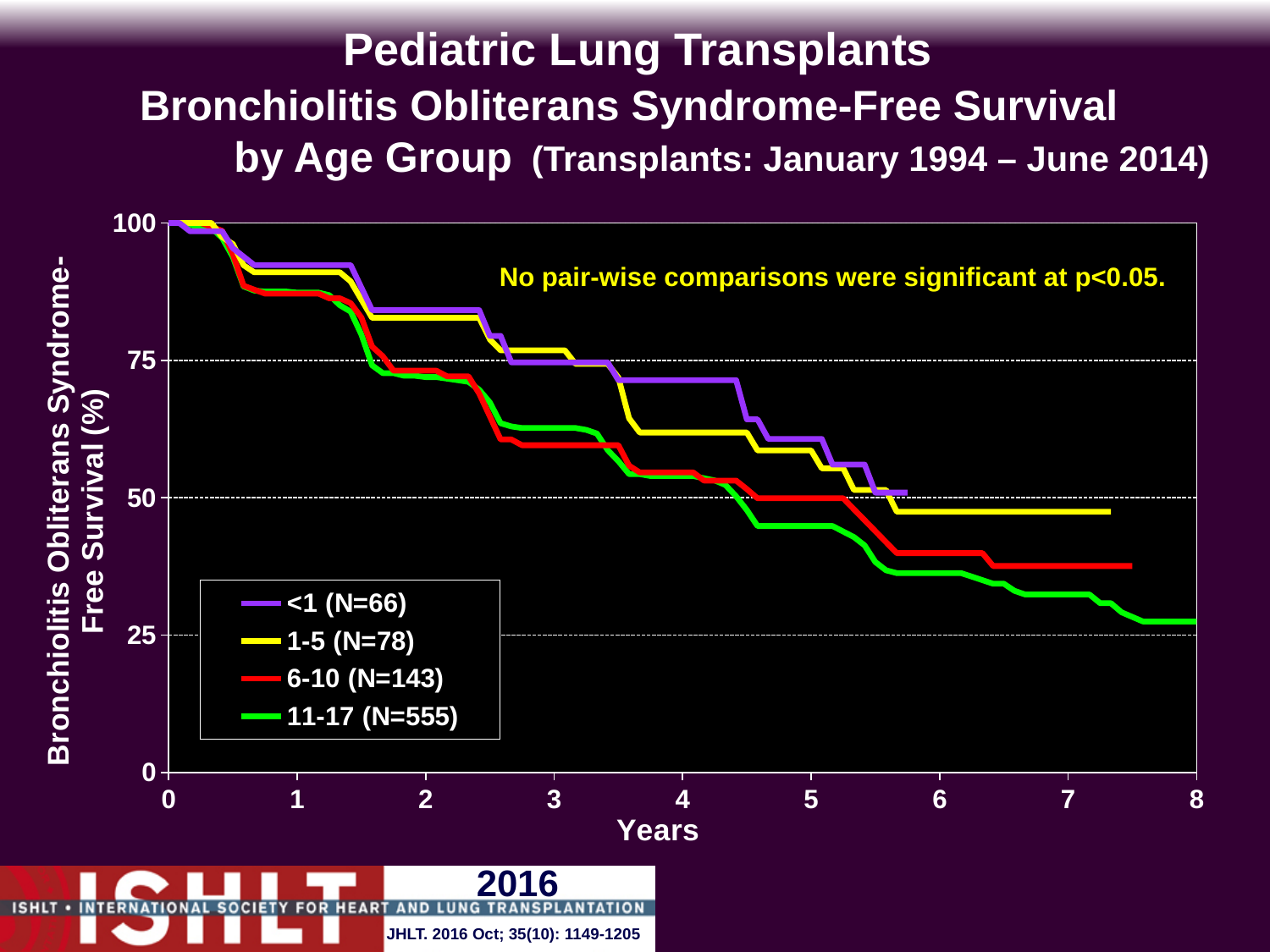
Do the survival curves rise or fall as years increase? fall Is the BOS-free survival for the 11-17 group at 4 years greater or less than 50%? greater What is the label of the x axis? Years What kind of chart is shown on the slide? line chart Which age group has the largest number of patients (N) in the legend? 11-17 (N=555) What is the N for the 1-5 age group shown in the legend? 78 Which age group's curve is lowest at 6 years? 11-17 At 5 years, which group has higher BOS-free survival, 1-5 or 11-17? 1-5 How many age groups does the legend list? 4 Is the BOS-free survival for the 11-17 group at 8 years greater or less than 25%? greater Is the BOS-free survival for the 6-10 group at 6 years greater or less than 50%? less